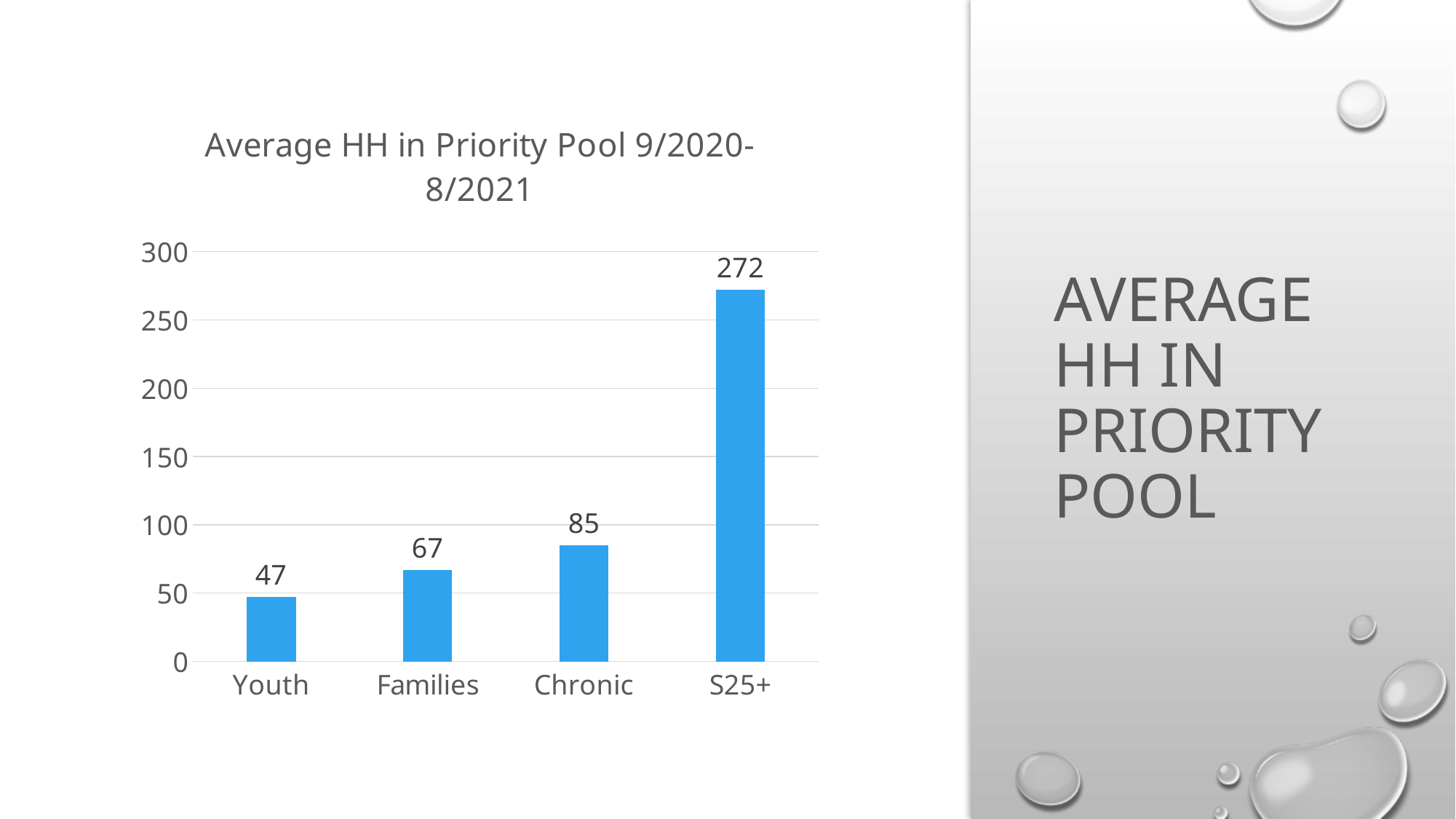
What is the difference between the values for S25+ and Chronic? 187 What is the value for S25+? 272 Which is larger, the value for Chronic or the value for Families? Chronic What is the title of the chart? Average HH in Priority Pool 9/2020-8/2021 Which category has the highest value? S25+ Which category has the lowest value? Youth What is the value for Youth? 47 How many categories are shown on the x axis? 4 What is the value for Families? 67 What is the difference between the values for Families and Youth? 20 What is the value for Chronic? 85 What kind of chart is this? Bar chart